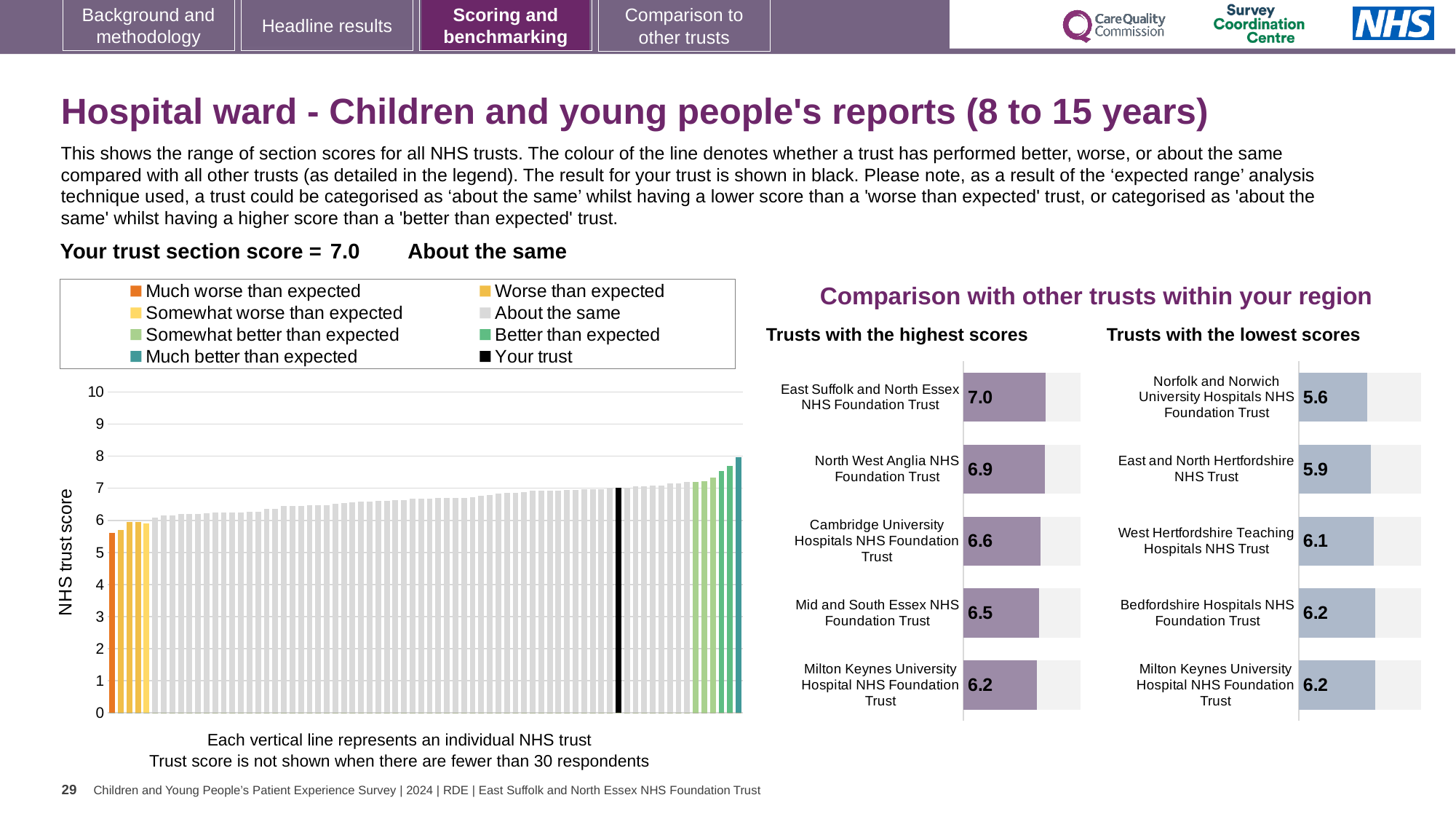
In the 'Trusts with the highest scores' chart, what is the difference between the scores of East Suffolk and North Essex NHS Foundation Trust and Milton Keynes University Hospital NHS Foundation Trust? 0.8 In the large chart on the left, is the value of the black bar (your trust) greater or less than 6? greater In the 'Trusts with the lowest scores' chart, what is the score for Norfolk and Norwich University Hospitals NHS Foundation Trust? 5.6 What kind of chart is the large chart on the left with the y axis labelled 'NHS trust score'? bar chart In the 'Trusts with the lowest scores' chart, which has the larger score: East and North Hertfordshire NHS Trust or West Hertfordshire Teaching Hospitals NHS Trust? West Hertfordshire Teaching Hospitals NHS Trust In the 'Trusts with the highest scores' chart, how many trusts are shown? 5 In the 'Trusts with the highest scores' chart, what is the score for Cambridge University Hospitals NHS Foundation Trust? 6.6 In the 'Trusts with the lowest scores' chart, what is the difference between the scores of West Hertfordshire Teaching Hospitals NHS Trust and Norfolk and Norwich University Hospitals NHS Foundation Trust? 0.5 In the 'Trusts with the lowest scores' chart, which trust has the lowest score? Norfolk and Norwich University Hospitals NHS Foundation Trust In the large chart on the left, do the trust scores rise or fall from left to right? rise In the large chart on the left, how many entries does the legend list? 8 In the 'Trusts with the highest scores' chart, which trust has the highest score? East Suffolk and North Essex NHS Foundation Trust